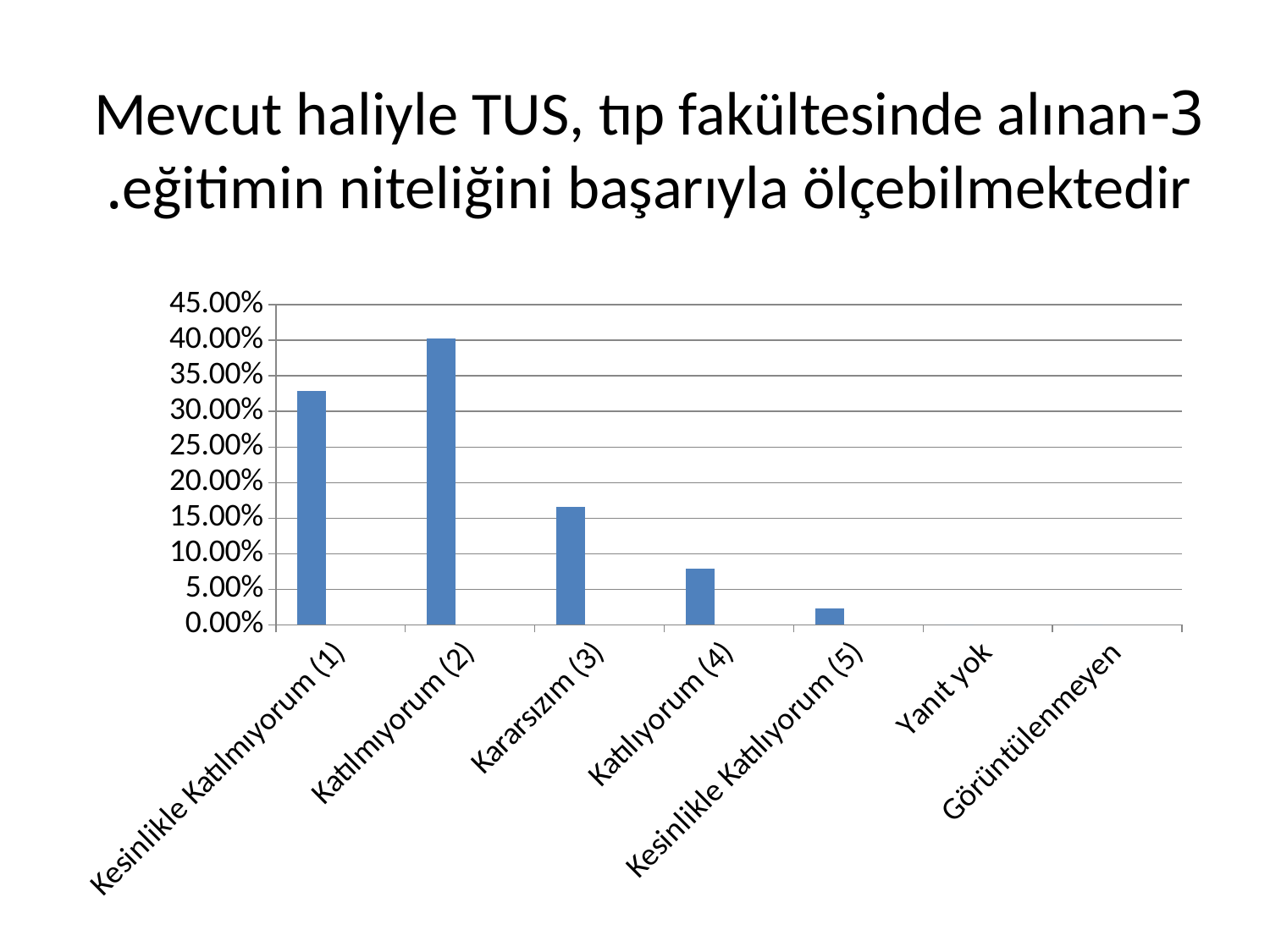
Which category has the highest value in the chart? Katılmıyorum (2) Which is larger, the value for Katılıyorum (4) or the value for Kesinlikle Katılıyorum (5)? Katılıyorum (4) Is the value for Katılıyorum (4) greater or less than 10.00%? less What kind of chart is shown on the slide? bar chart Is the value for Kesinlikle Katılıyorum (5) greater or less than 5.00%? less Which is larger, the value for Kesinlikle Katılmıyorum (1) or the value for Kararsızım (3)? Kesinlikle Katılmıyorum (1) Is the value for Kararsızım (3) greater or less than 20.00%? less Do the values rise or fall from Katılmıyorum (2) to Kesinlikle Katılıyorum (5)? fall How many categories are shown on the x axis of the chart? 7 What is the highest value shown on the y axis of the chart? 45.00%